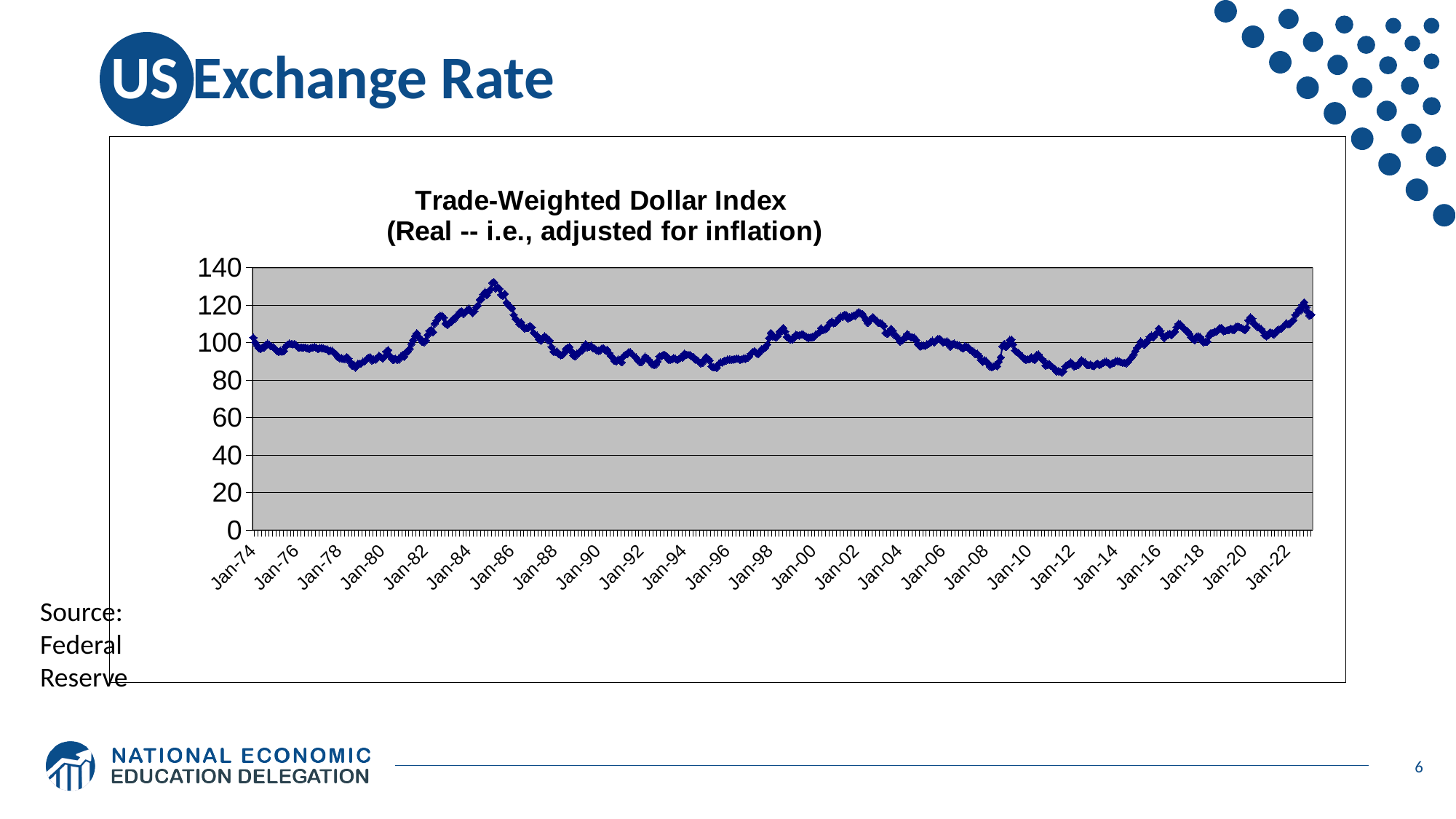
Is the value of the index around Jan-02 greater or less than 100? greater Does the index rise or fall between Jan-86 and Jan-88? fall What is the highest value shown on the vertical axis of the chart? 140 Is the value of the index around Jan-12 greater or less than 100? less Which is higher, the index value around Jan-85 or the index value around Jan-12? Jan-85 Is the value of the index at Jan-74 greater or less than 80? greater Does the index rise or fall between Jan-80 and Jan-85? rise What is the title of the chart? Trade-Weighted Dollar Index (Real -- i.e., adjusted for inflation) What kind of chart is shown on the slide? line chart